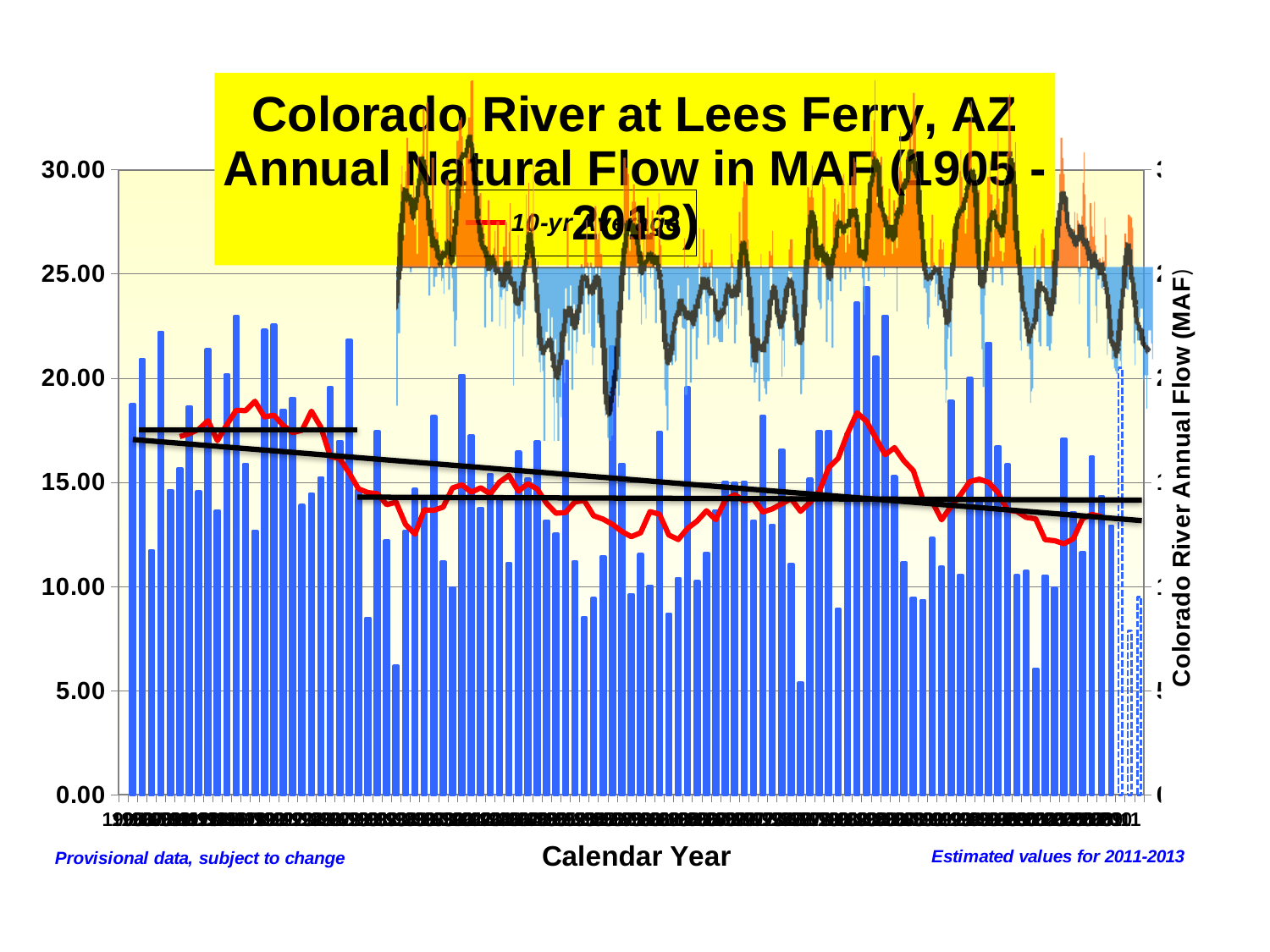
What is the label on the x axis of the chart? Calendar Year Is the value of the shortest bar greater or less than 10.00? less Do the black trend lines drawn across the bars rise or fall from left to right? fall Is the value of the tallest bar greater or less than 20.00? greater Is the value of the leftmost bar greater or less than 15.00? greater What is the title of the chart? Colorado River at Lees Ferry, AZ Annual Natural Flow in MAF (1905 - 2013) What kind of chart is used to show the annual natural flow values? bar chart